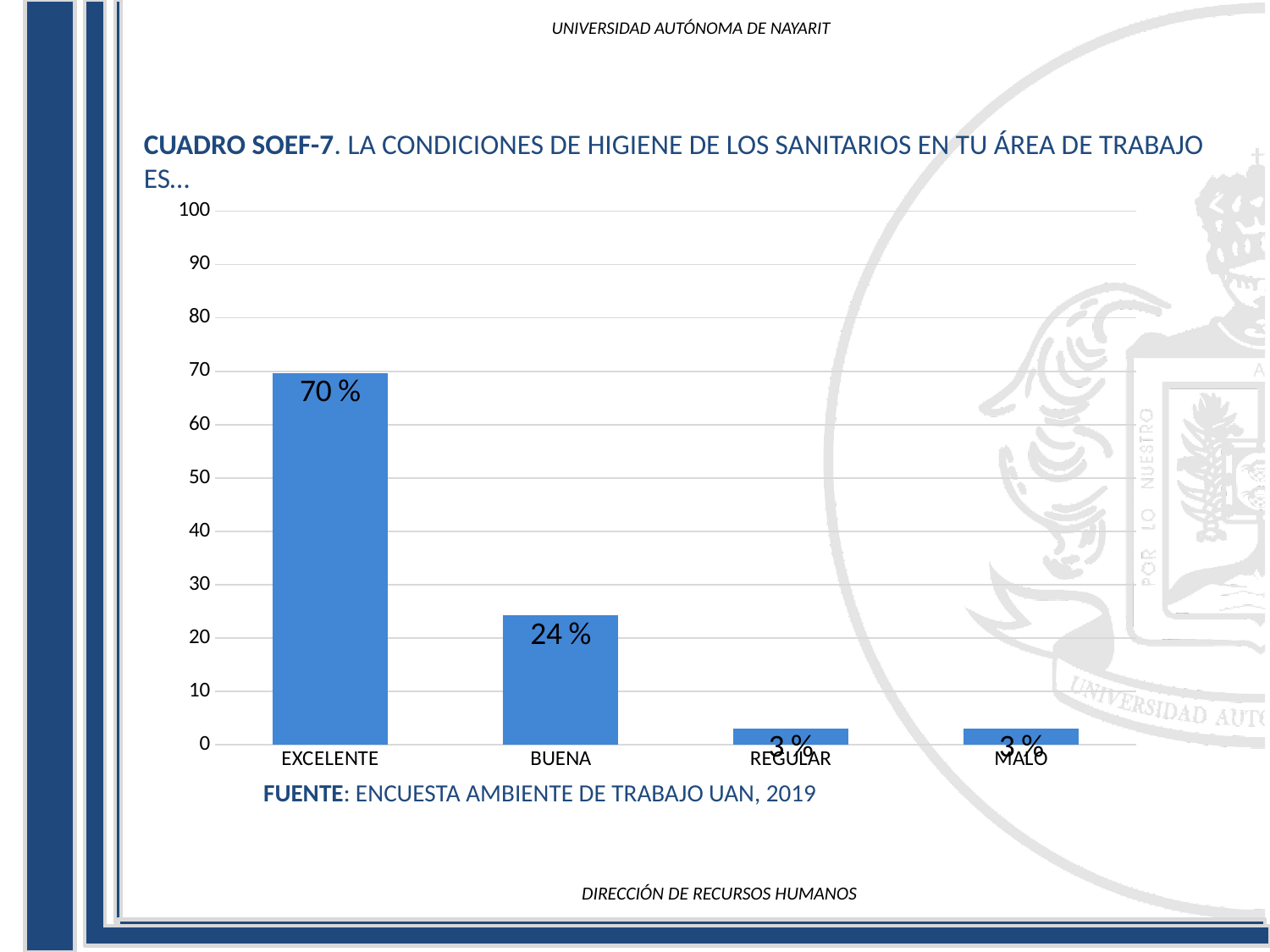
Do the values rise or fall moving from left to right along the x axis? fall What percentage of respondents rated the hygiene conditions as EXCELENTE? 70 % Which category has the highest value? EXCELENTE What is the difference between the EXCELENTE and BUENA values? 46 % What value is shown for the REGULAR category? 3 % Which is larger, the value for BUENA or the value for REGULAR? BUENA What kind of chart is shown on the slide? bar chart What is the value shown for the BUENA category? 24 % What source is cited below the chart? ENCUESTA AMBIENTE DE TRABAJO UAN, 2019 Is the value for EXCELENTE greater or less than 60? greater What value is shown for the MALO category? 3 % How many categories are shown on the x axis? 4